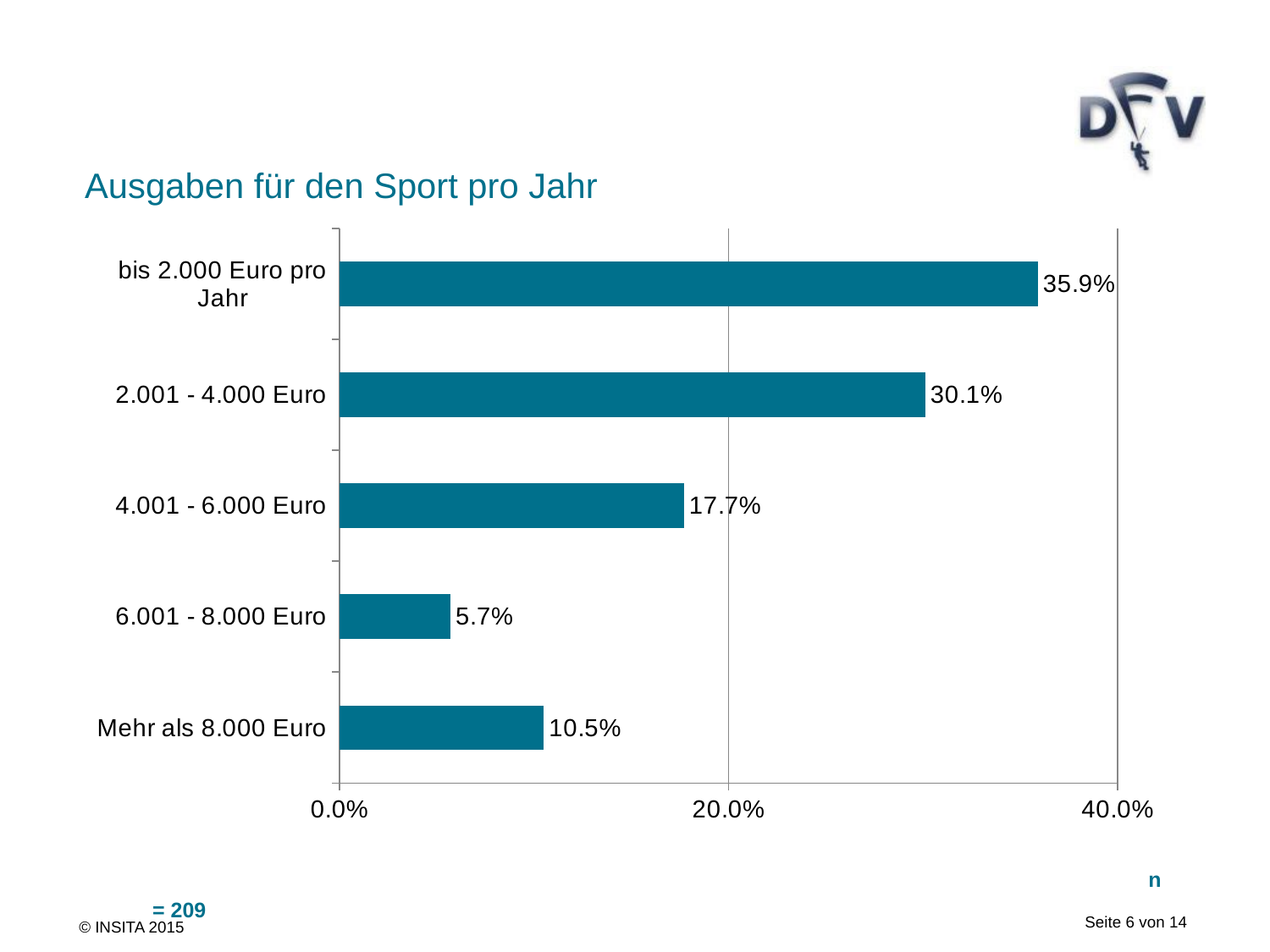
What is the value for "Mehr als 8.000 Euro"? 10.5% What is the value for "bis 2.000 Euro pro Jahr"? 35.9% What is the difference between the values for "bis 2.000 Euro pro Jahr" and "2.001 - 4.000 Euro"? 5.8% How many categories are shown in the chart? 5 Which is larger, the value for "4.001 - 6.000 Euro" or the value for "Mehr als 8.000 Euro"? 4.001 - 6.000 Euro What is the value for "6.001 - 8.000 Euro"? 5.7% What kind of chart is shown on the slide? bar chart What is the value for "2.001 - 4.000 Euro"? 30.1% Which category has the lowest value? 6.001 - 8.000 Euro Which category has the highest value? bis 2.000 Euro pro Jahr Is the value for "2.001 - 4.000 Euro" greater or less than 20.0%? greater What is the title of the chart? Ausgaben für den Sport pro Jahr